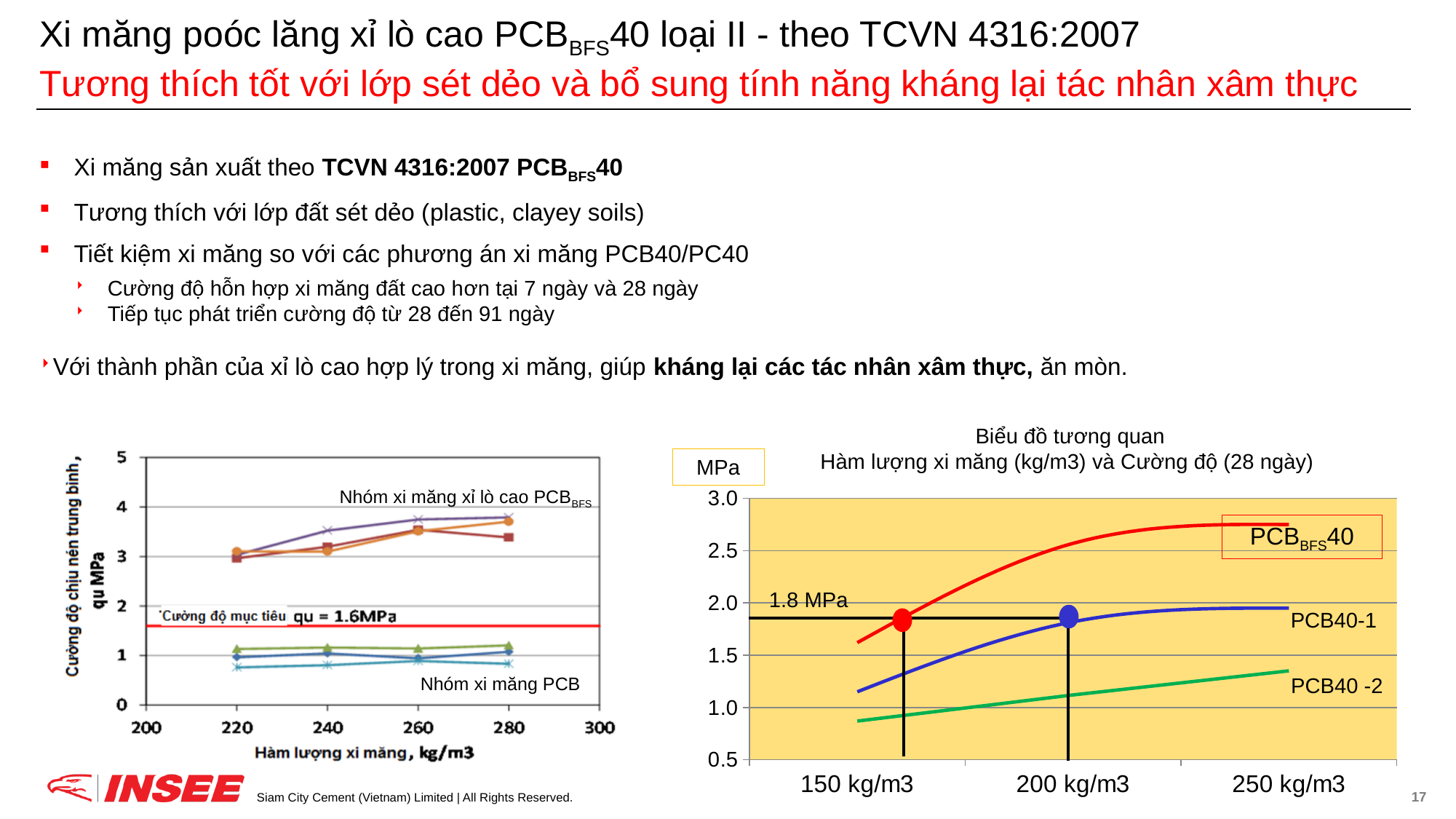
In the right-hand chart (Biểu đồ tương quan), which cement curve is the lowest? PCB40 -2 In the left-hand chart, at 280 kg/m3 are the values for the Nhóm xi măng xỉ lò cao PCBBFS group greater or less than 3? greater In the right-hand chart (Biểu đồ tương quan), which cement curve is the highest? PCBBFS40 In the right-hand chart (Biểu đồ tương quan), what strength value is marked by the horizontal reference line? 1.8 MPa In the right-hand chart (Biểu đồ tương quan), how many cement curves are plotted? 3 In the right-hand chart (Biểu đồ tương quan), at 150 kg/m3 is the value for PCB40 -2 greater or less than 1.0? less In the right-hand chart (Biểu đồ tương quan), does the PCB40 -2 curve rise or fall as cement content increases from 150 to 250 kg/m3? rise In the right-hand chart (Biểu đồ tương quan), at 250 kg/m3 is the value for PCBBFS40 greater or less than 2.5? greater What kind of chart is the right-hand chart titled 'Biểu đồ tương quan Hàm lượng xi măng (kg/m3) và Cường độ (28 ngày)'? line chart In the left-hand chart, what is the label of the x axis? Hàm lượng xi măng, kg/m3 In the right-hand chart (Biểu đồ tương quan), which is larger at 200 kg/m3: PCBBFS40 or PCB40-1? PCBBFS40 In the left-hand chart, what target strength (Cường độ mục tiêu) is marked by the red line? qu = 1.6MPa